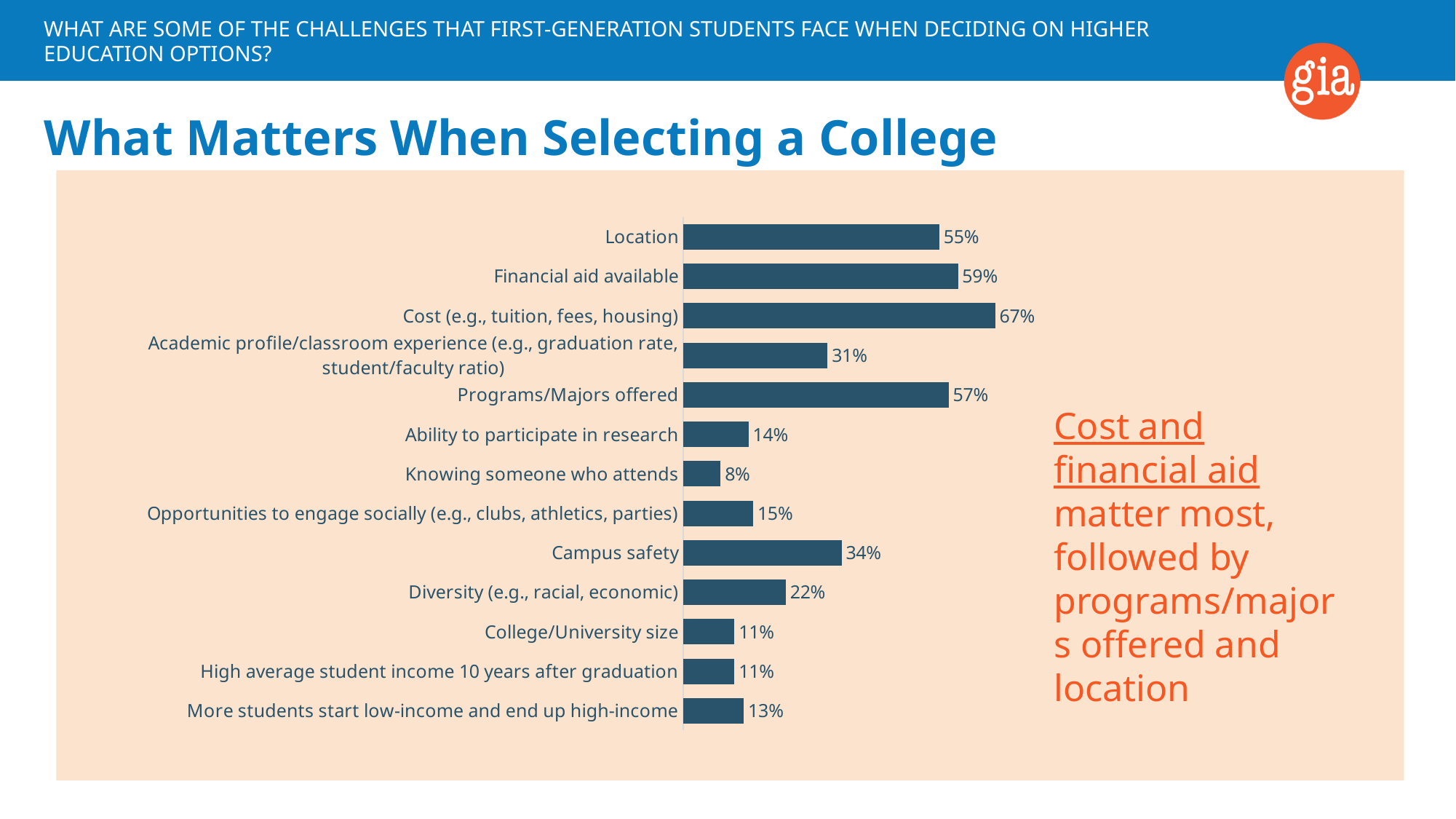
Which category has the lowest value? Knowing someone who attends What percentage is shown for Campus safety? 34% What is the title of the chart on the slide? What Matters When Selecting a College What is the difference between the values for Cost (e.g., tuition, fees, housing) and Financial aid available? 8% What percentage is shown for Location? 55% What percentage is shown for Knowing someone who attends? 8% How many categories are shown in the chart? 13 What percentage is shown for Financial aid available? 59% Which category has the highest value? Cost (e.g., tuition, fees, housing) What is the difference between the values for Campus safety and Diversity (e.g., racial, economic)? 12% What kind of chart is shown on the slide? Bar chart Which is larger, the value for Programs/Majors offered or the value for Location? Programs/Majors offered